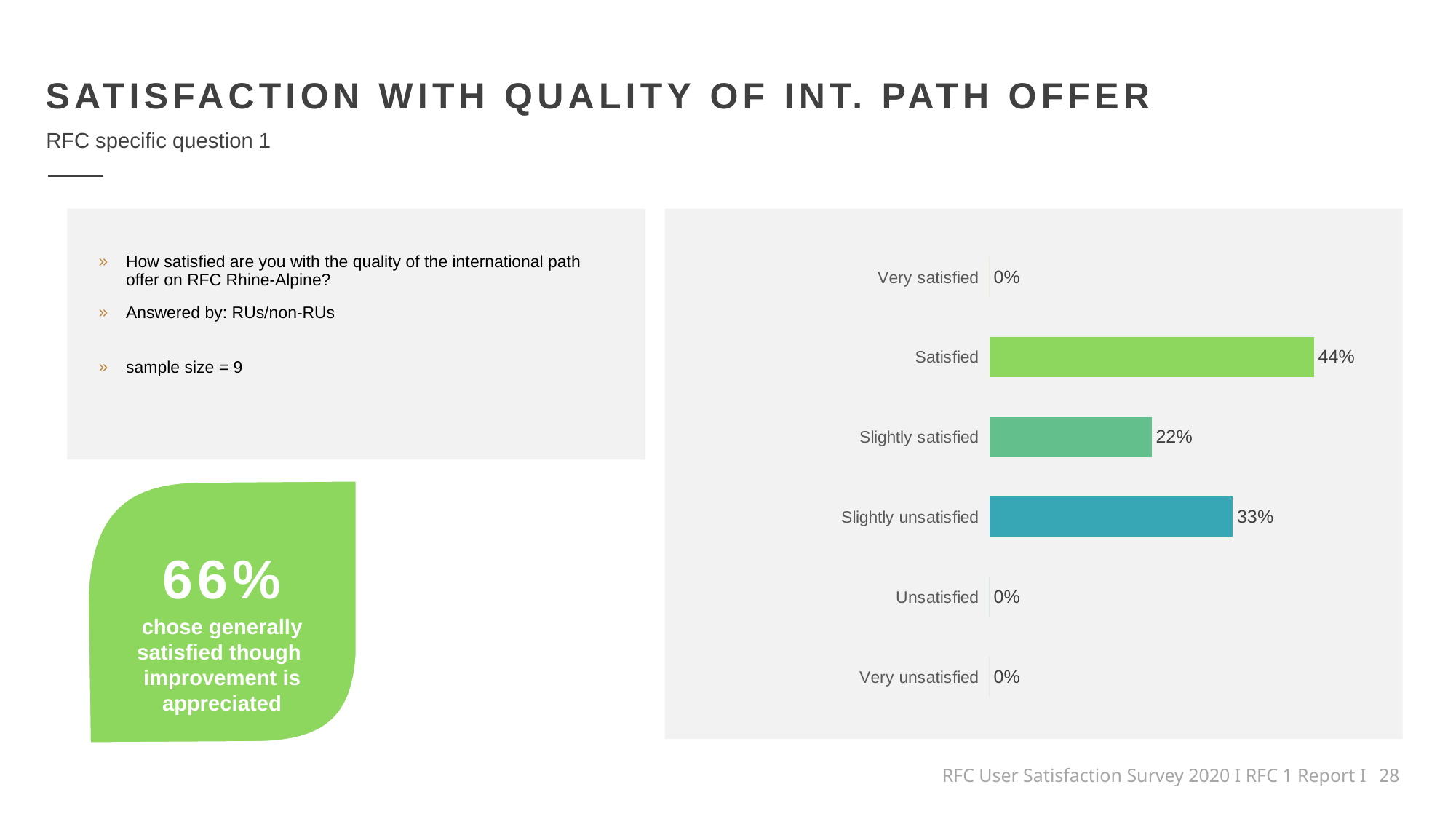
What percentage of respondents chose "Satisfied"? 44% What is the value for "Very satisfied"? 0% Which category has the highest value? Satisfied What is the value for "Slightly unsatisfied"? 33% Which is larger, the value for "Slightly satisfied" or the value for "Slightly unsatisfied"? Slightly unsatisfied What is the combined value of "Satisfied" and "Slightly satisfied"? 66% How many categories are shown in the chart? 6 How many categories have a value of 0%? 3 What is the value for "Slightly satisfied"? 22% What is the difference between the values for "Slightly unsatisfied" and "Slightly satisfied"? 11% What is the difference between the values for "Satisfied" and "Slightly unsatisfied"? 11% What kind of chart is shown on the slide? Bar chart